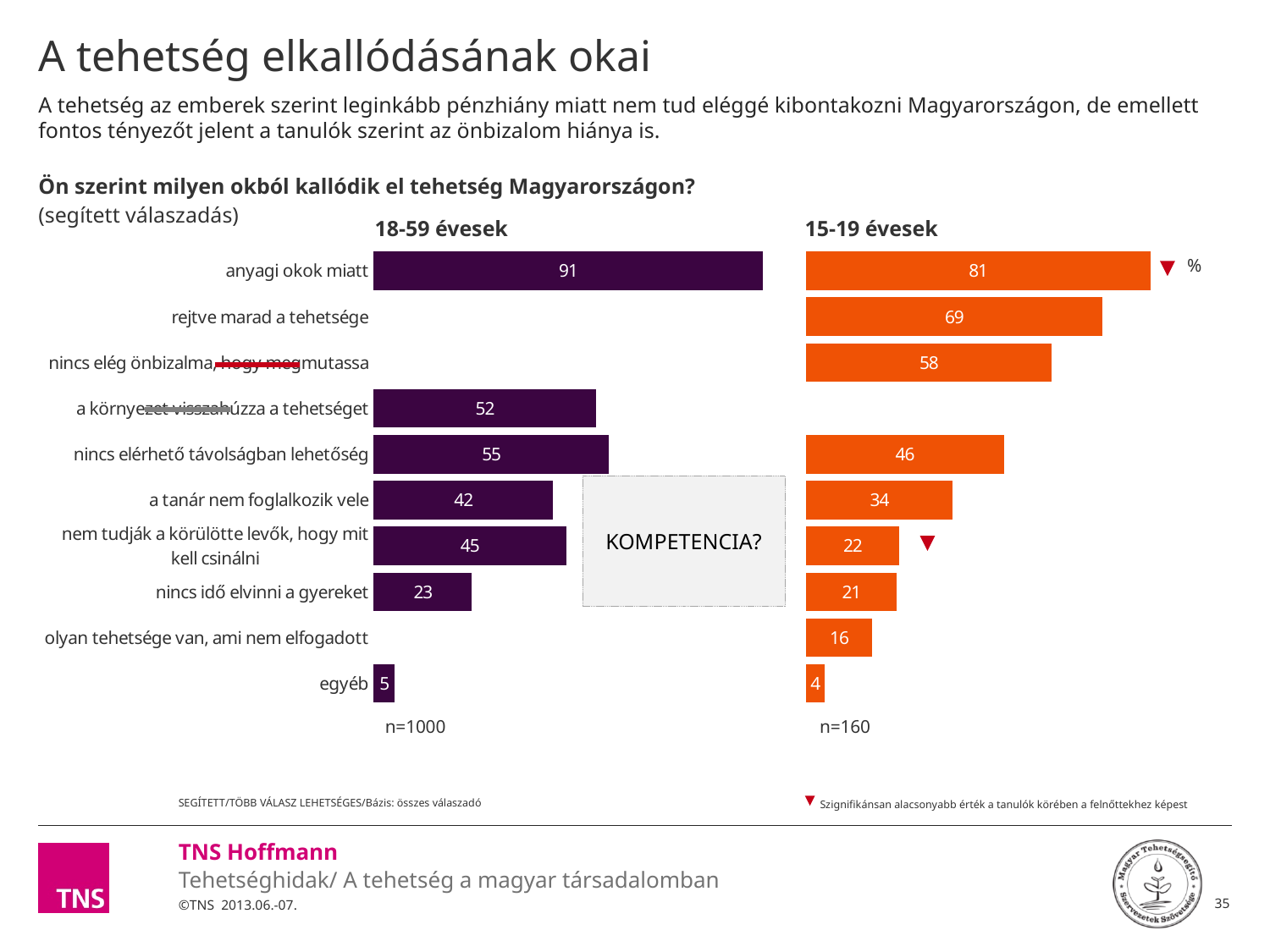
What is the difference between the 'anyagi okok miatt' values in the 18-59 évesek chart and the 15-19 évesek chart? 10 In the 15-19 évesek chart, which category has the highest value? anyagi okok miatt In the 18-59 évesek chart, what is the difference between 'nincs elérhető távolságban lehetőség' and 'a tanár nem foglalkozik vele'? 13 For 'nem tudják a körülötte levők, hogy mit kell csinálni', which chart shows the larger value, 18-59 évesek or 15-19 évesek? 18-59 évesek What is the sample size (n) shown under the 15-19 évesek chart? n=160 In the 18-59 évesek chart, which category has the lowest value? egyéb In the 15-19 évesek chart, what is the value for 'rejtve marad a tehetsége'? 69 In the 15-19 évesek chart, what is the value for 'nincs elég önbizalma, hogy megmutassa'? 58 In the 18-59 évesek chart, what is the value for 'anyagi okok miatt'? 91 In the 18-59 évesek chart, what is the value for 'nincs idő elvinni a gyereket'? 23 In the 15-19 évesek chart, which is larger: 'a tanár nem foglalkozik vele' or 'nincs elérhető távolságban lehetőség'? nincs elérhető távolságban lehetőség What type of chart is used on this slide? bar chart